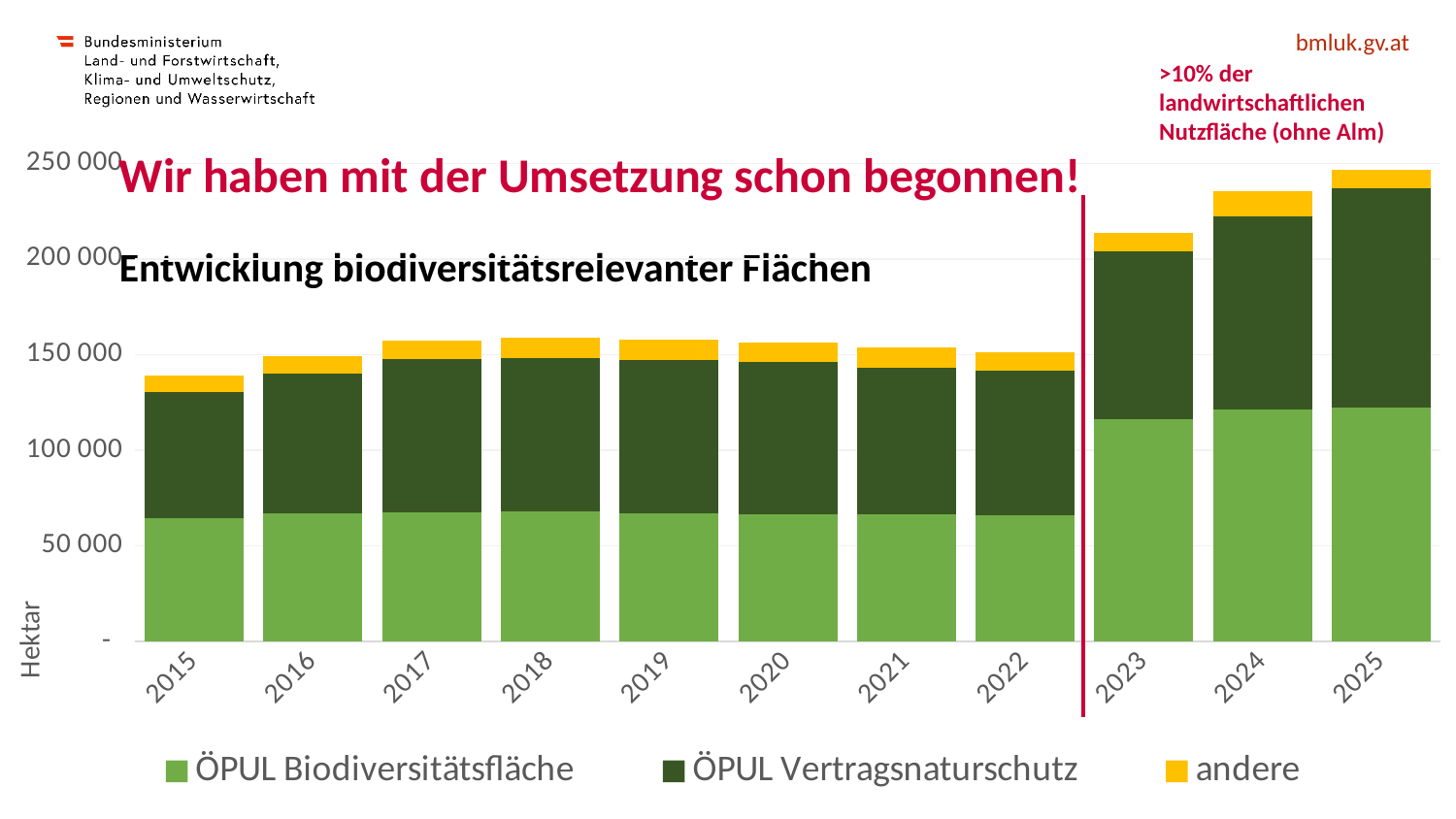
Is the ÖPUL Biodiversitätsfläche value for 2016 greater or less than 100 000? less Is the total value for 2015 greater or less than 150 000? less Is the total value for 2025 greater or less than 200 000? greater Do the total values rise or fall from 2022 to 2025? rise What unit is shown on the y axis of the chart? Hektar Which year has the lowest total bar in the chart? 2015 How many series does the chart legend list? 3 Which year has the highest total bar in the chart? 2025 What kind of chart is shown on the slide? Stacked bar chart Which year has the larger total bar, 2019 or 2024? 2024 How many years are shown on the x axis of the chart? 11